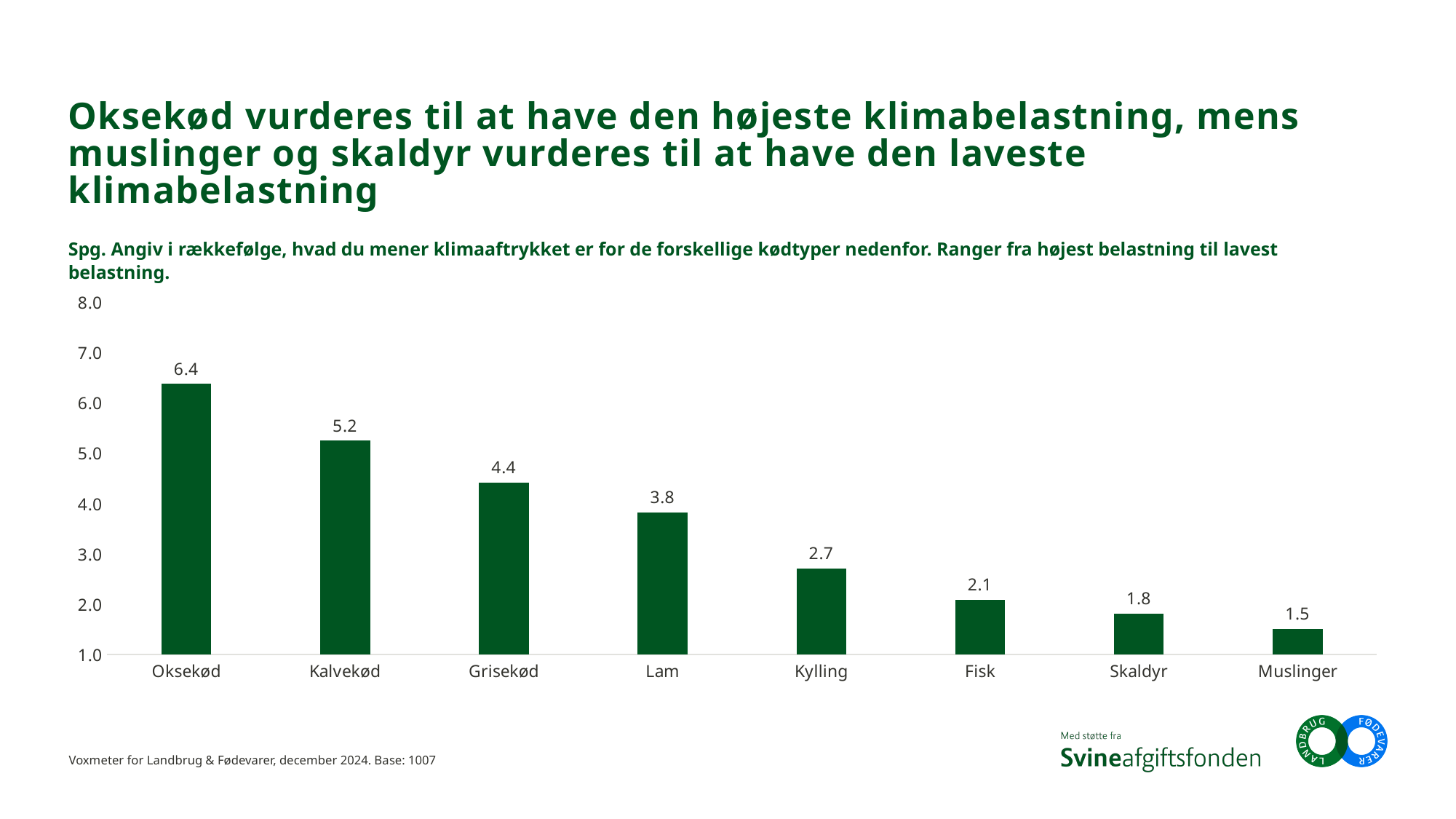
What kind of chart is shown on the slide? Bar chart Which category has the lowest value? Muslinger What is the difference between the values for Lam and Fisk? 1.7 What is the value for Kylling? 2.7 How many categories are shown on the x axis? 8 Which category has the highest value? Oksekød Which is larger, the value for Grisekød or the value for Lam? Grisekød What is the value for Skaldyr? 1.8 Do the values rise or fall from left to right along the x axis? Fall Is the value for Kalvekød greater or less than 5.0? greater What is the value for Oksekød? 6.4 What is the difference between the values for Oksekød and Kalvekød? 1.2